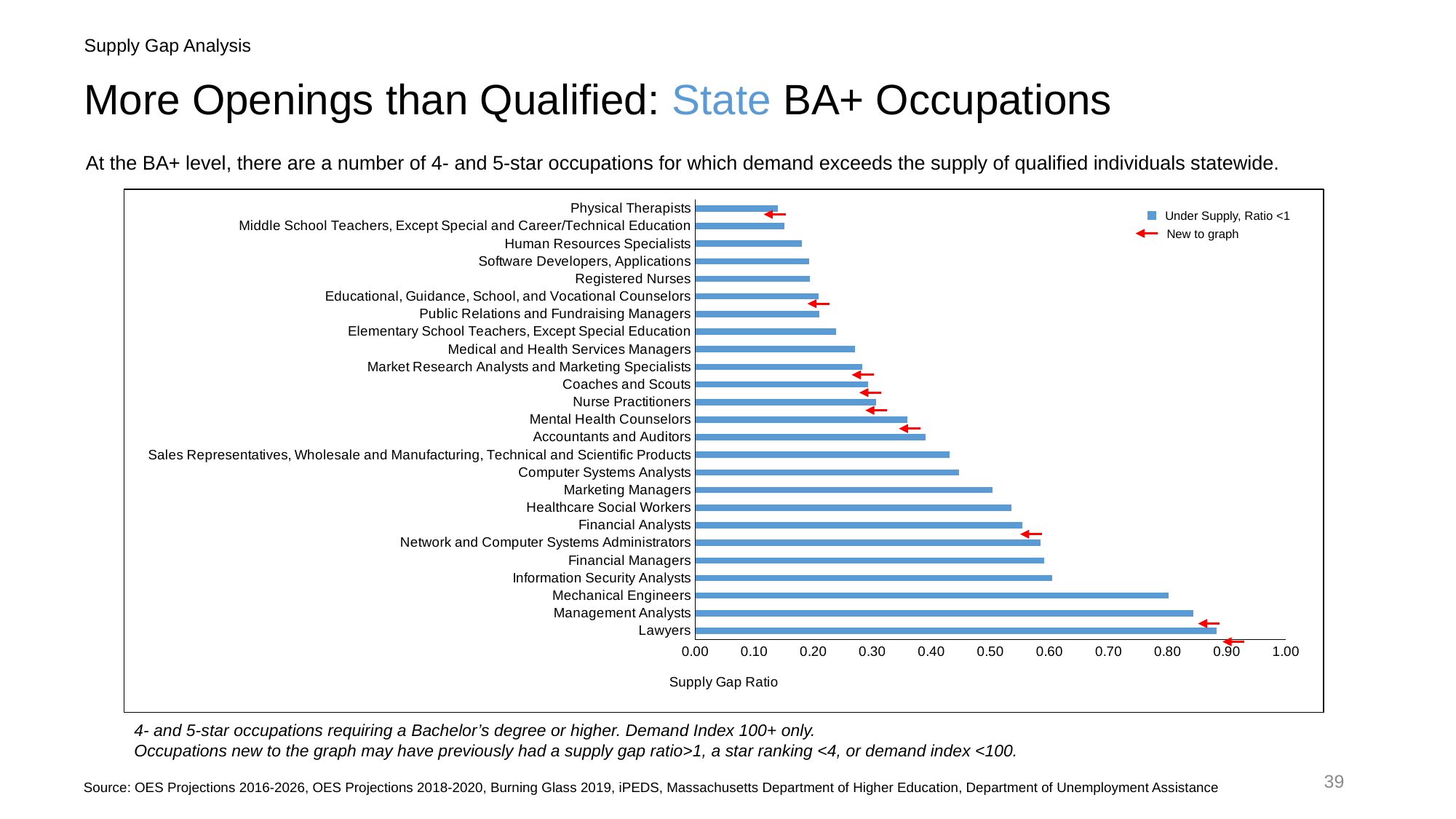
Which has a larger supply gap ratio, Mechanical Engineers or Marketing Managers? Mechanical Engineers How many occupations are plotted in the chart? 25 What does the red arrow symbol in the legend indicate? New to graph Is the supply gap ratio for Mental Health Counselors greater or less than 0.30? greater Is the supply gap ratio for Computer Systems Analysts greater or less than 0.50? less Is the supply gap ratio for Lawyers greater or less than 0.80? greater Which has a larger supply gap ratio, Physical Therapists or Accountants and Auditors? Accountants and Auditors What is the label of the horizontal axis of the chart? Supply Gap Ratio Which occupation has the highest supply gap ratio in the chart? Lawyers What kind of chart is shown on the slide? Bar chart